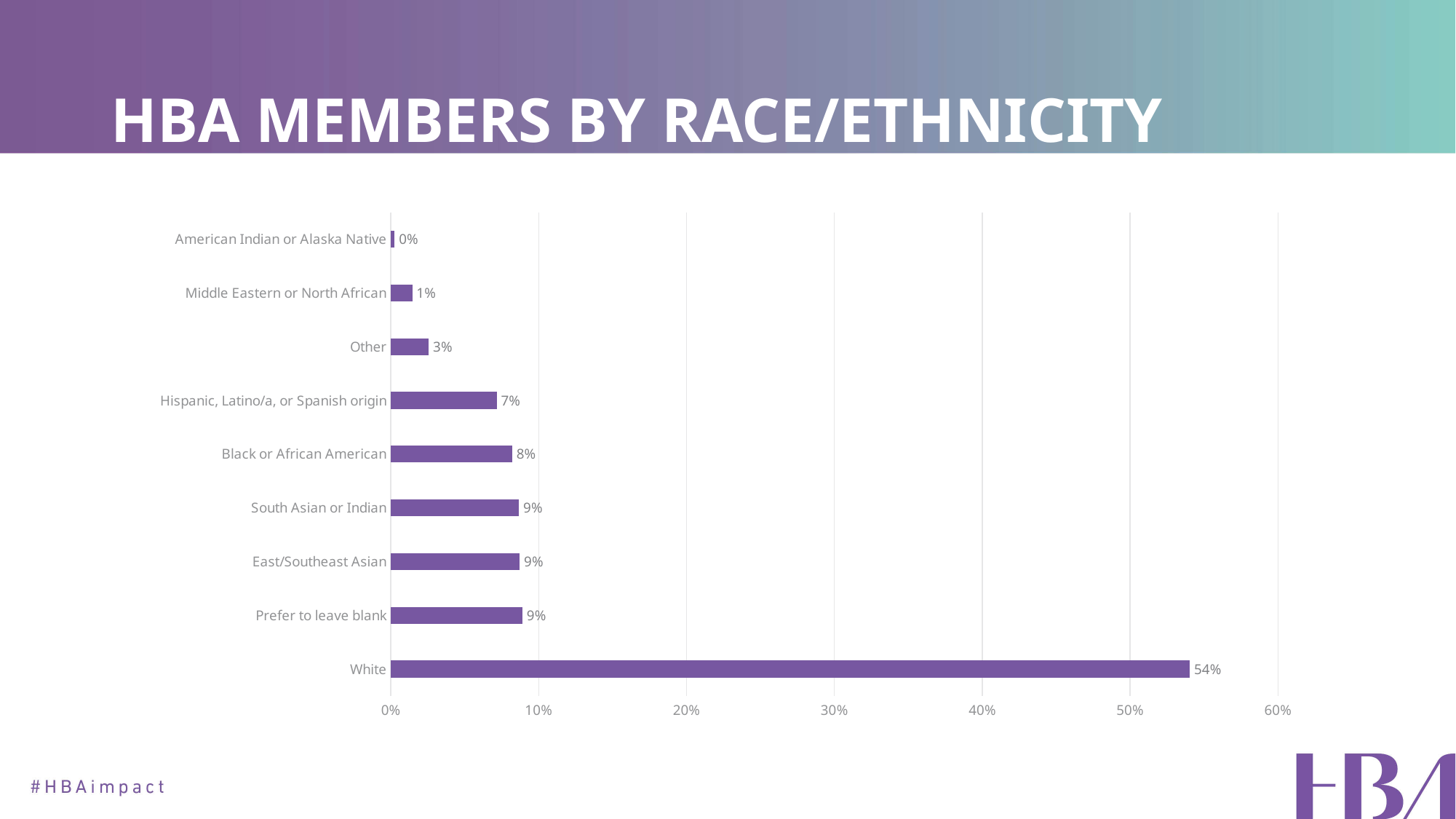
Which race/ethnicity category has the lowest percentage of HBA members? American Indian or Alaska Native Is the value for White greater or less than 50%? greater What percentage of HBA members are White? 54% Which is larger, the percentage for Other or the percentage for Hispanic, Latino/a, or Spanish origin? Hispanic, Latino/a, or Spanish origin How many race/ethnicity categories are shown in the chart? 9 Which race/ethnicity category has the highest percentage of HBA members? White What type of chart is used on this slide? Bar chart What percentage of HBA members chose 'Prefer to leave blank'? 9% What percentage of HBA members are Black or African American? 8% What percentage of HBA members are Middle Eastern or North African? 1% What is the difference in percentage points between White and Black or African American members? 46 What percentage of HBA members are Hispanic, Latino/a, or Spanish origin? 7%